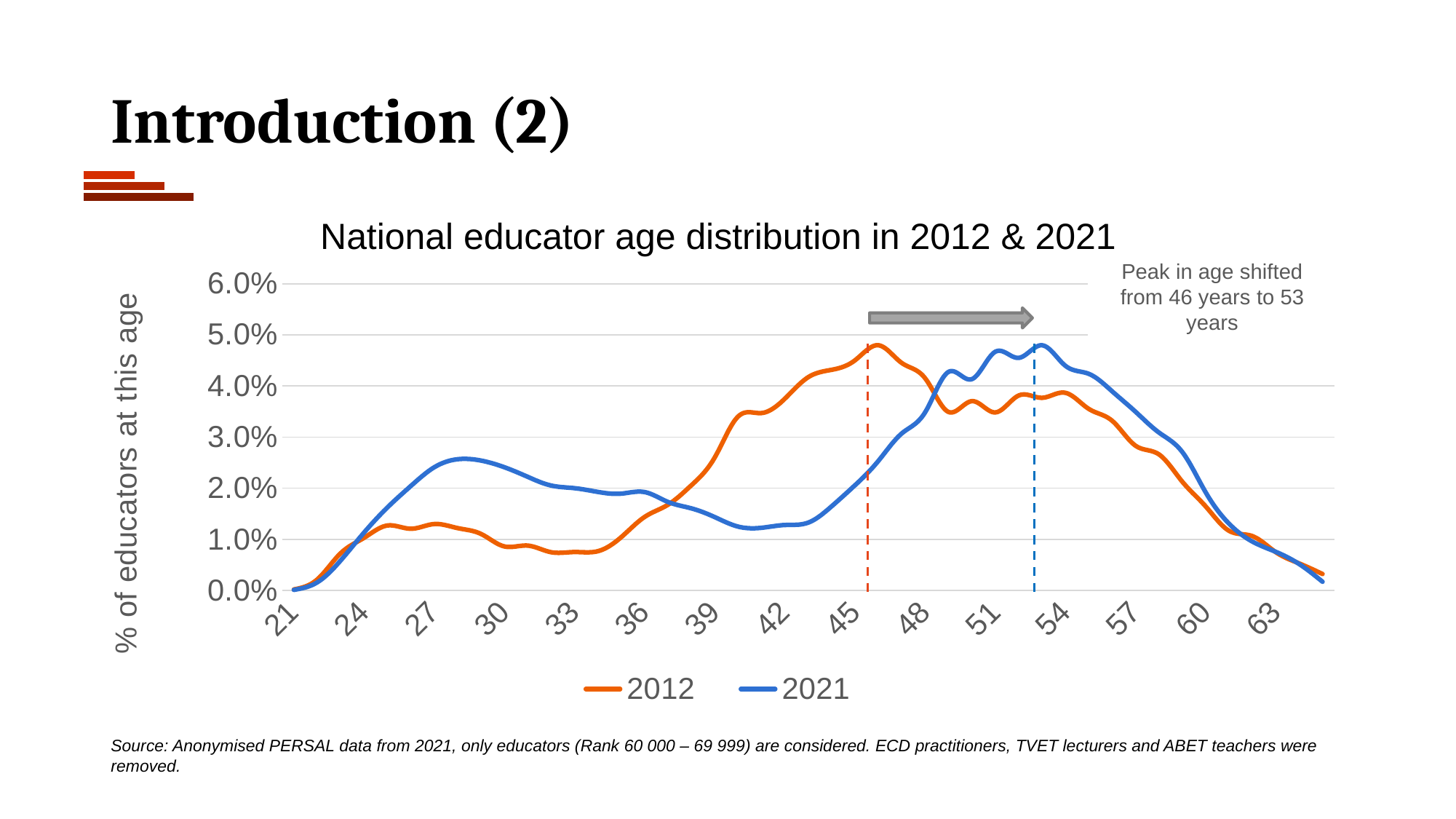
Is the value for 2021 at age 30 greater or less than 2.0%? greater Which colour represents the 2021 series? Blue At age 42, which series has the higher value, 2012 or 2021? 2012 Is the value for 2012 at age 33 greater or less than 1.0%? less What kind of chart is shown on the slide? Line chart Is the value for 2012 at age 46 greater or less than 4.0%? greater At age 27, which series has the higher value, 2012 or 2021? 2021 At what age does the 2012 distribution peak, according to the annotation? 46 years How many series does the legend list? 2 At what age does the 2021 distribution peak, according to the annotation? 53 years What is the title of the chart? National educator age distribution in 2012 & 2021